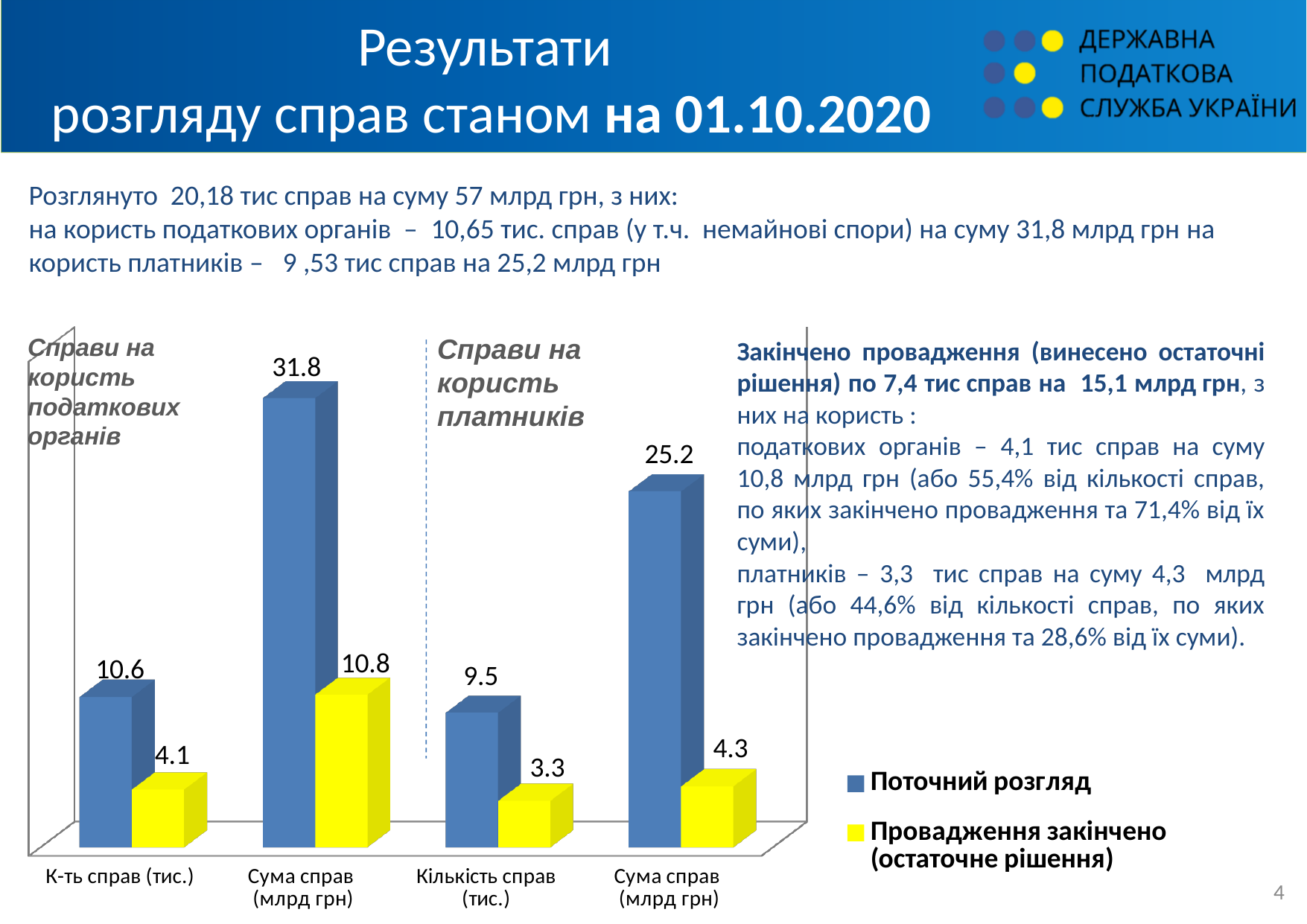
How many categories are shown along the x axis of the chart? 4 What is the value of "Провадження закінчено (остаточне рішення)" for "К-ть справ (тис.)" in the group "Справи на користь податкових органів"? 4.1 What is the value of "Поточний розгляд" for "Кількість справ (тис.)" in the group "Справи на користь платників"? 9.5 How many series does the chart legend list? 2 Which is larger: the "Провадження закінчено (остаточне рішення)" value for "Сума справ (млрд грн)" in the group "Справи на користь податкових органів" or in the group "Справи на користь платників"? Справи на користь податкових органів What colour are the bars for the "Провадження закінчено (остаточне рішення)" series? yellow What type of chart is shown on the slide? bar chart Which category has the lowest value for the "Провадження закінчено (остаточне рішення)" series? Кількість справ (тис.) in the group Справи на користь платників What is the value of "Поточний розгляд" for "Сума справ (млрд грн)" in the group "Справи на користь податкових органів"? 31.8 What is the value of "Провадження закінчено (остаточне рішення)" for "Сума справ (млрд грн)" in the group "Справи на користь платників"? 4.3 What is the difference between the "Поточний розгляд" and "Провадження закінчено (остаточне рішення)" values for "Сума справ (млрд грн)" in the group "Справи на користь платників"? 20.9 Which category has the highest value for the "Поточний розгляд" series? Сума справ (млрд грн) in the group Справи на користь податкових органів